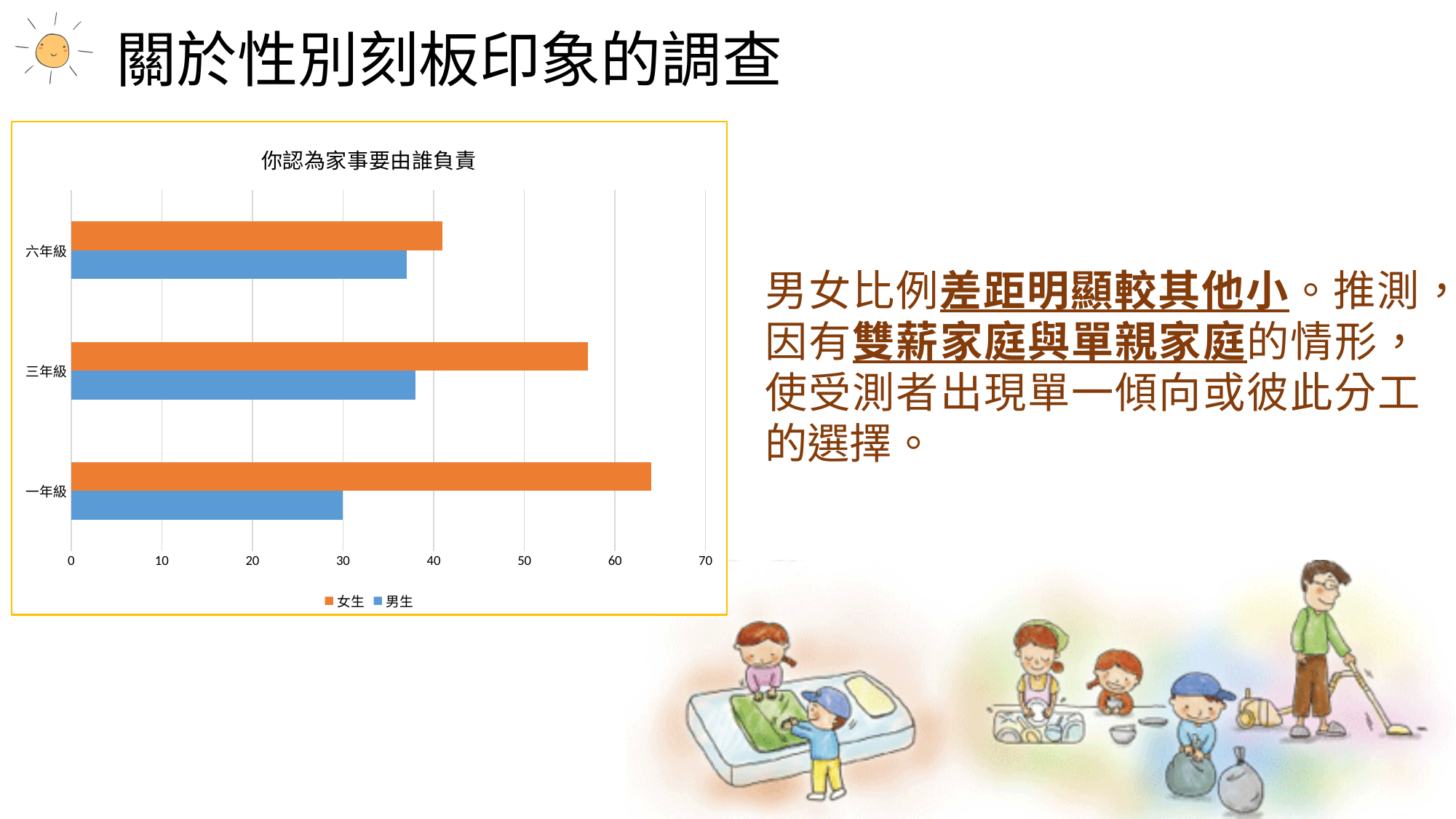
For 一年級, which is larger, 女生 or 男生? 女生 Which grade has the lowest value for 女生? 六年級 Do the 女生 values rise or fall from 一年級 to 六年級? fall Which grade has the highest value for 女生? 一年級 How many grade categories are shown on the chart? 3 What is the title of the chart? 你認為家事要由誰負責 What kind of chart is shown on the slide? bar chart Which grade has the lowest value for 男生? 一年級 Which colour represents the 女生 series? orange Is the value for 三年級 女生 greater or less than 50? greater Is the value for 女生 in 一年級 greater or less than 60? greater How many series does the legend list? 2